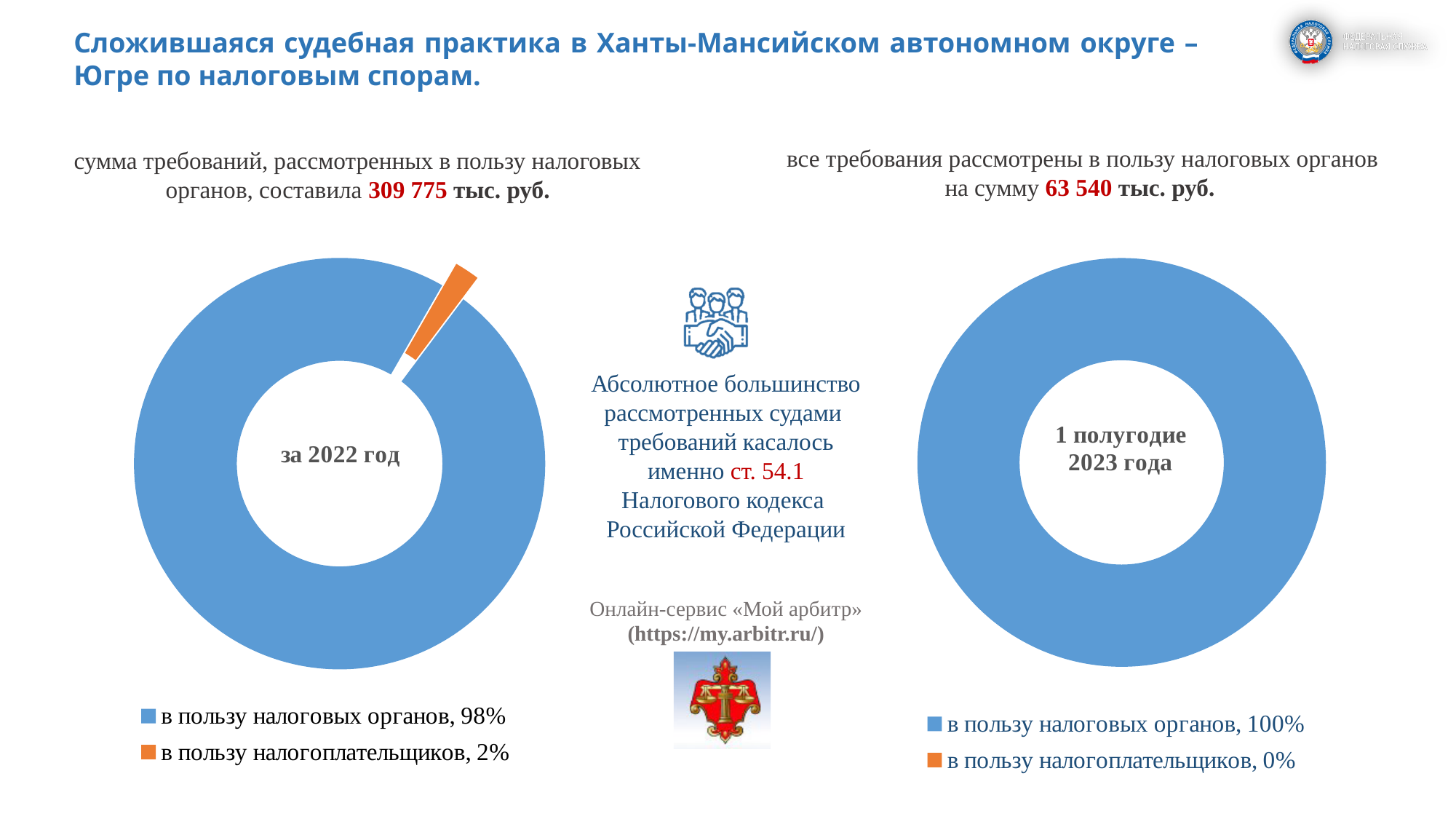
What type of chart is the left chart (за 2022 год)? Doughnut (pie) chart In the left chart (за 2022 год), which category has the largest share? в пользу налоговых органов In the left chart (за 2022 год), what is the difference in percentage points between the share in favour of tax authorities and the share in favour of taxpayers? 96 How many entries does the legend of the right chart (1 полугодие 2023 года) list? 2 In the left chart (за 2022 год), which category has the smallest share? в пользу налогоплательщиков In the right chart (1 полугодие 2023 года), what share of claims was decided in favour of tax authorities (в пользу налоговых органов)? 100% In the left chart (за 2022 год), what share of claims was decided in favour of taxpayers (в пользу налогоплательщиков)? 2% In the left chart (за 2022 год), what colour is the slice for в пользу налогоплательщиков? Orange In the right chart (1 полугодие 2023 года), what share of claims was decided in favour of taxpayers (в пользу налогоплательщиков)? 0% What label is shown in the centre of the right chart? 1 полугодие 2023 года In the left chart (за 2022 год), which is larger: the share in favour of tax authorities or the share in favour of taxpayers? в пользу налоговых органов